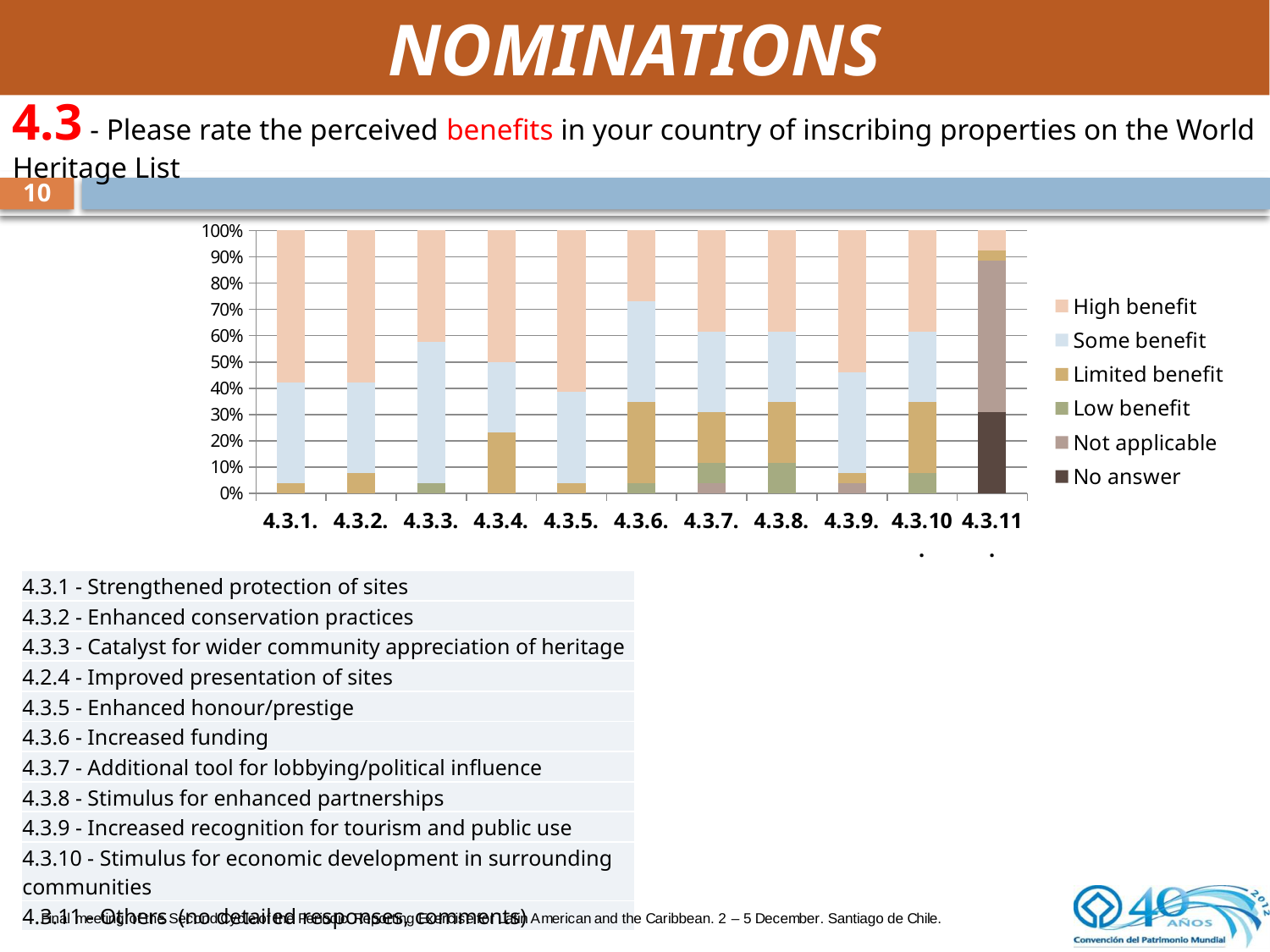
Is the High benefit share for 4.3.6 greater or less than 40%? less Which series is listed first in the chart legend? High benefit Is the No answer share for 4.3.11 greater or less than 20%? greater Which series is listed last in the chart legend? No answer How many categories are shown along the x axis of the chart? 11 Is the High benefit share for 4.3.5 greater or less than 50%? greater How many series does the chart legend list? 6 Which has the larger High benefit share, 4.3.1 or 4.3.6? 4.3.1 Which category has the largest Not applicable share? 4.3.11 What kind of chart is shown on the slide? Stacked bar chart Which category is the only one with a No answer share? 4.3.11 Which category has the smallest High benefit share? 4.3.11